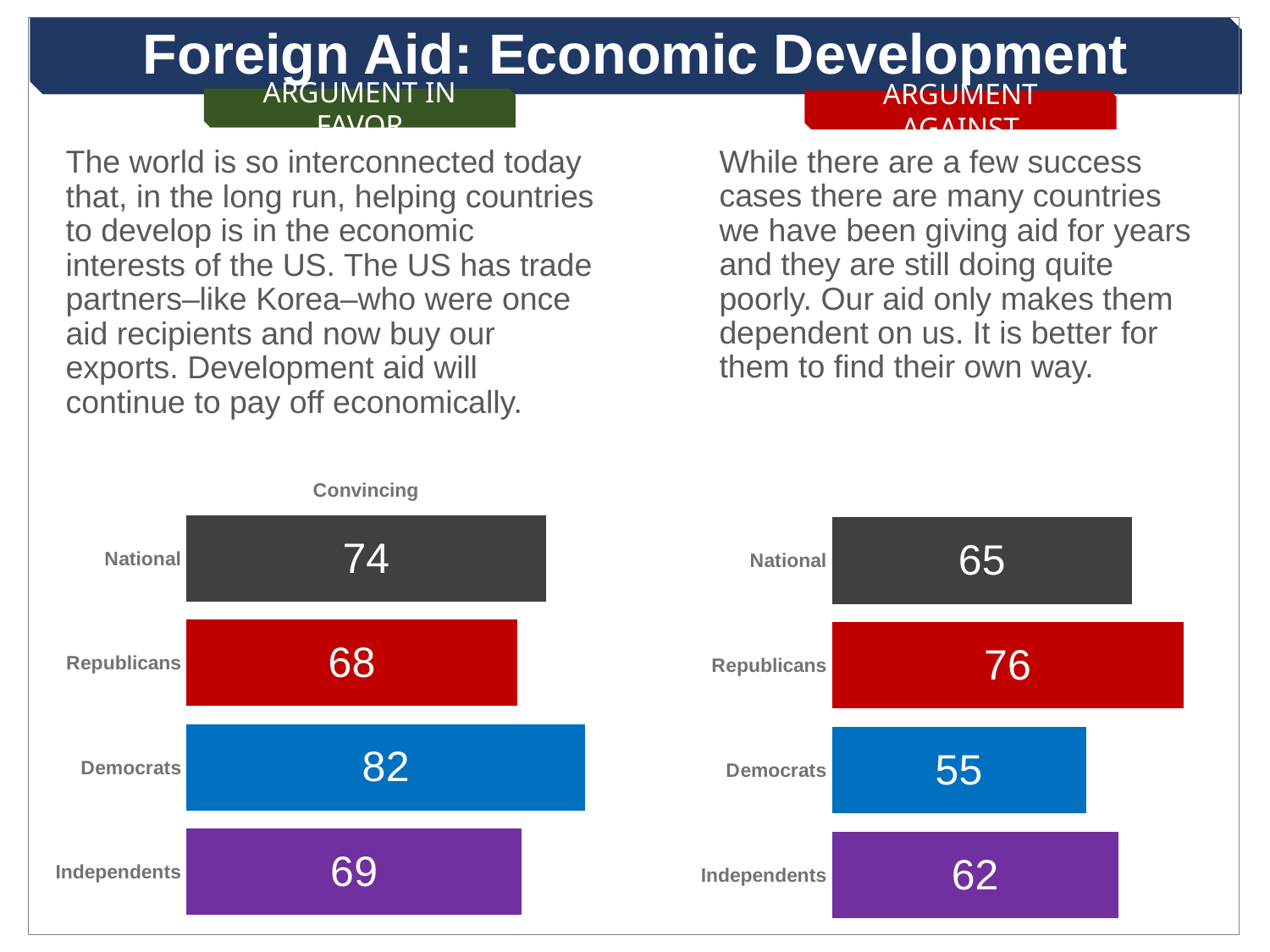
What type of chart is the left chart (Argument in Favor)? Bar chart Which is larger: the National value in the left chart (Argument in Favor) or the National value in the right chart (Argument Against)? Left chart (Argument in Favor) How many groups are shown in the right chart (Argument Against)? 4 In the right chart (Argument Against), what is the difference between the Republicans value and the Democrats value? 21 In the left chart (Argument in Favor), which group has the lowest value? Republicans In the left chart (Argument in Favor), what is the value for Democrats? 82 In the right chart (Argument Against), which group has the lowest value? Democrats In the right chart (Argument Against), what is the value for Republicans? 76 In the right chart (Argument Against), what is the value for Independents? 62 In the left chart (Argument in Favor), what is the difference between the Democrats value and the Independents value? 13 In the left chart (Argument in Favor), which group has the highest value? Democrats In the left chart (Argument in Favor), what is the National value? 74